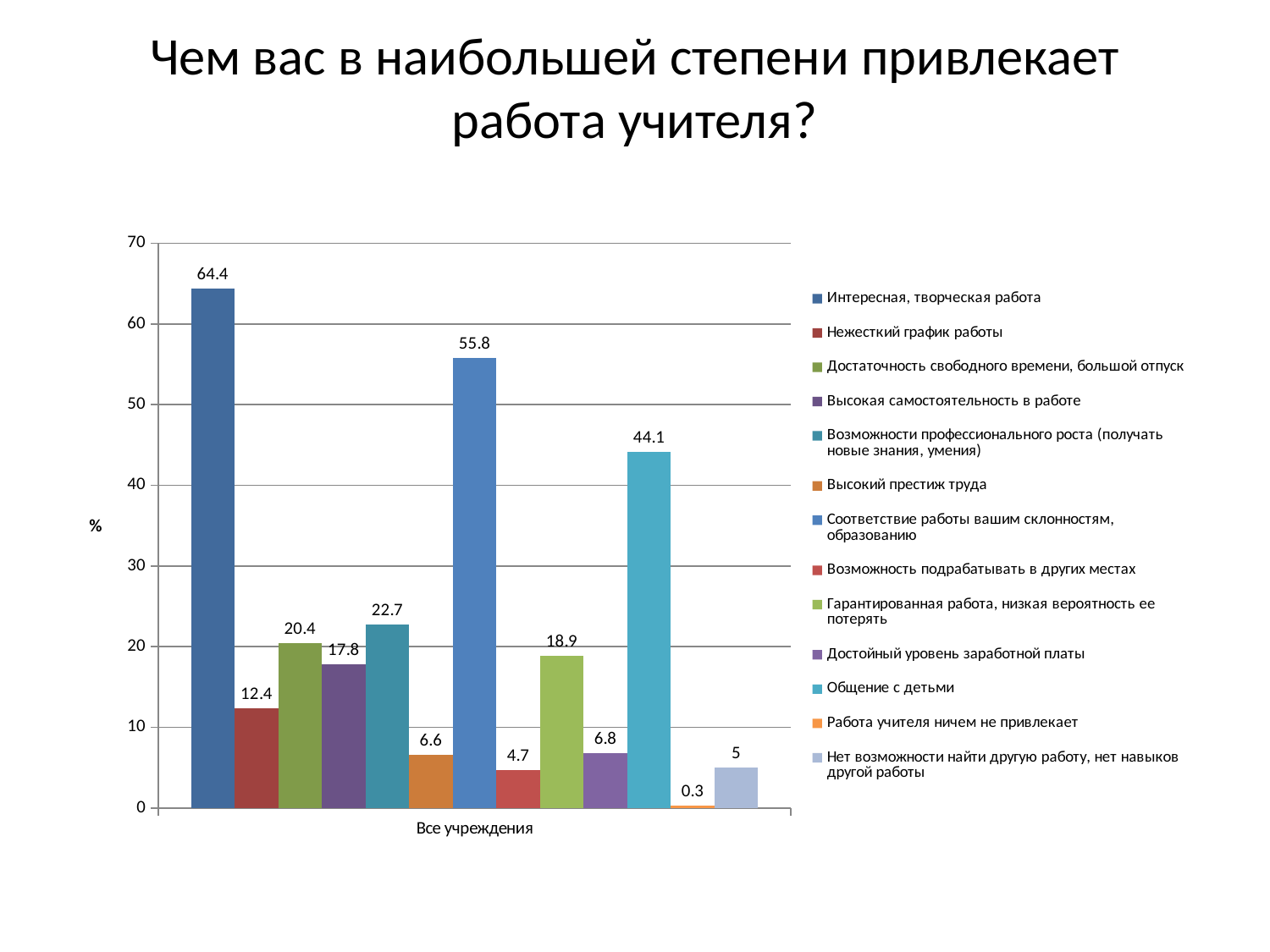
What is the value for "Соответствие работы вашим склонностям, образованию"? 55.8 What is the value for "Интересная, творческая работа"? 64.4 Which is larger: the value for "Достаточность свободного времени, большой отпуск" or for "Возможности профессионального роста (получать новые знания, умения)"? Возможности профессионального роста (получать новые знания, умения) What is the value for "Работа учителя ничем не привлекает"? 0.3 What kind of chart is shown on the slide? bar chart How many series does the legend list? 13 Which series has the highest value? Интересная, творческая работа Is the value for "Общение с детьми" greater or less than 40? greater What is the label of the category on the x axis? Все учреждения Which series has the lowest value? Работа учителя ничем не привлекает What is the value for "Общение с детьми"? 44.1 What is the difference between the values for "Интересная, творческая работа" and "Соответствие работы вашим склонностям, образованию"? 8.6